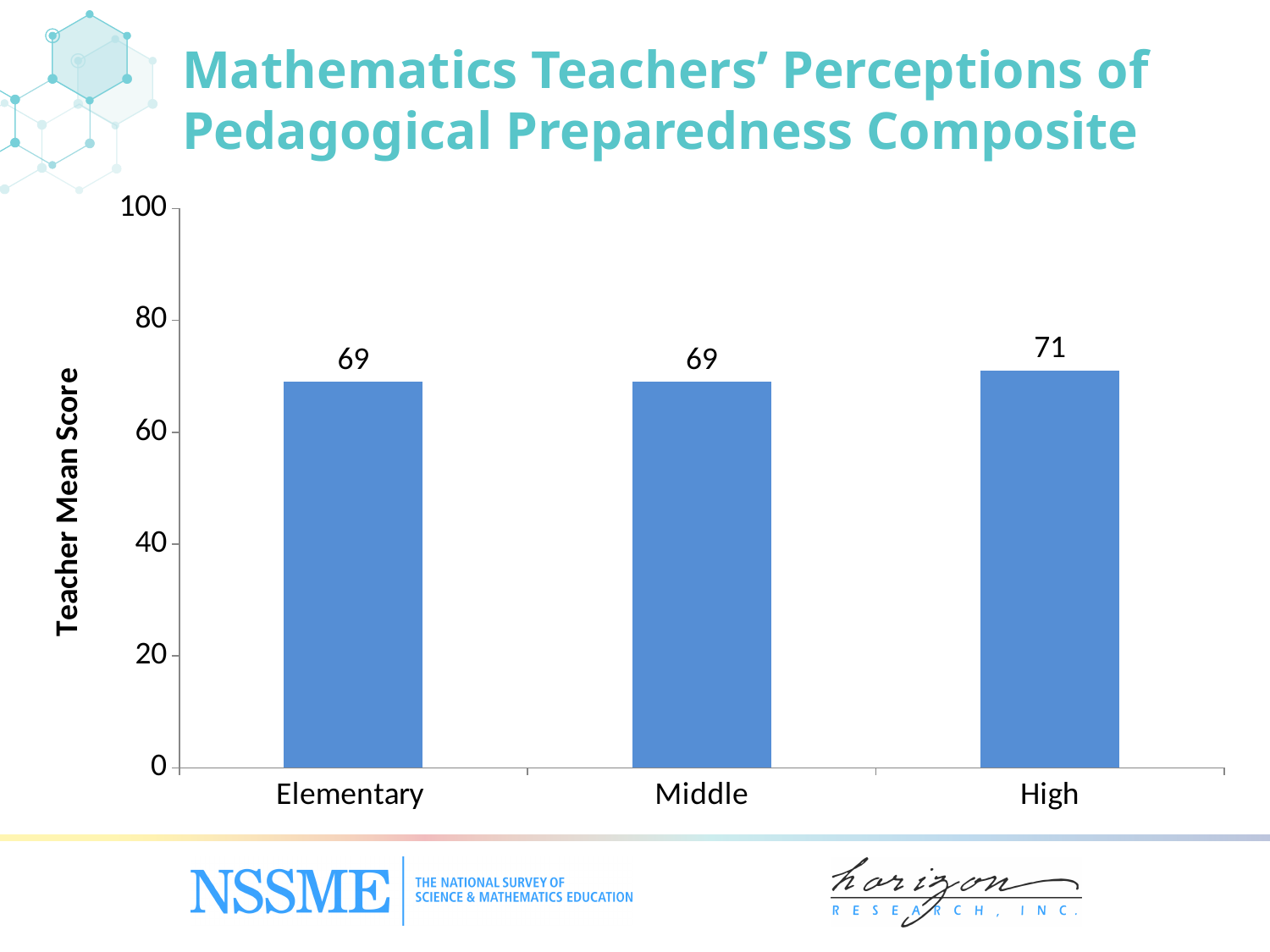
What kind of chart is shown on the slide? bar chart What is the label of the vertical axis? Teacher Mean Score How many grade-level categories are shown in the chart? 3 Is the value for Elementary greater or less than 80? less What is the difference between the teacher mean scores for High and Elementary? 2 What is the teacher mean score for Middle? 69 Which grade level has the highest teacher mean score? High What is the teacher mean score for Elementary? 69 Which is larger, the teacher mean score for High or for Middle? High What is the title of the chart? Mathematics Teachers' Perceptions of Pedagogical Preparedness Composite Is the value for High greater or less than 60? greater What is the teacher mean score for High? 71